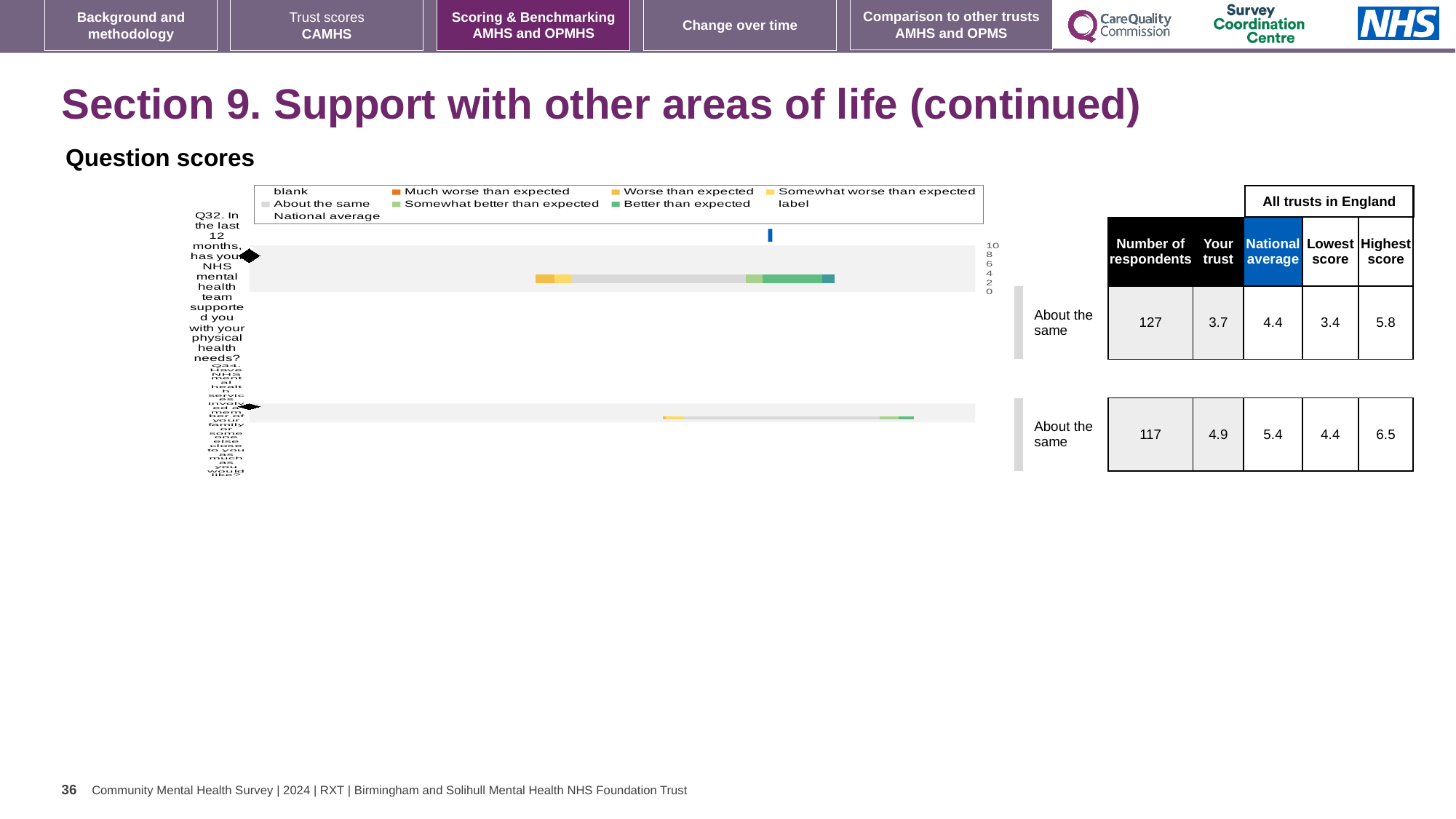
In the table beside the chart, what is the number of respondents for Q32? 127 Which legend entry is shown in grey in the chart? About the same In the table beside the chart, what is the difference between the highest score and the lowest score for Q32? 2.4 In the table beside the chart, what is the lowest score for Q34? 4.4 Which legend entry is shown in orange in the chart? Much worse than expected In the table beside the chart, what is the National average for Q34? 5.4 In the table beside the chart, what is the highest score for Q34? 6.5 How many entries does the chart legend list? 9 How many question categories (bars) are plotted in the chart? 2 In the table beside the chart, what is the 'Your trust' score for Q32? 3.7 What kind of chart is shown on the slide? bar chart In the table beside the chart, which is larger for Q32: the 'Your trust' score or the National average? National average